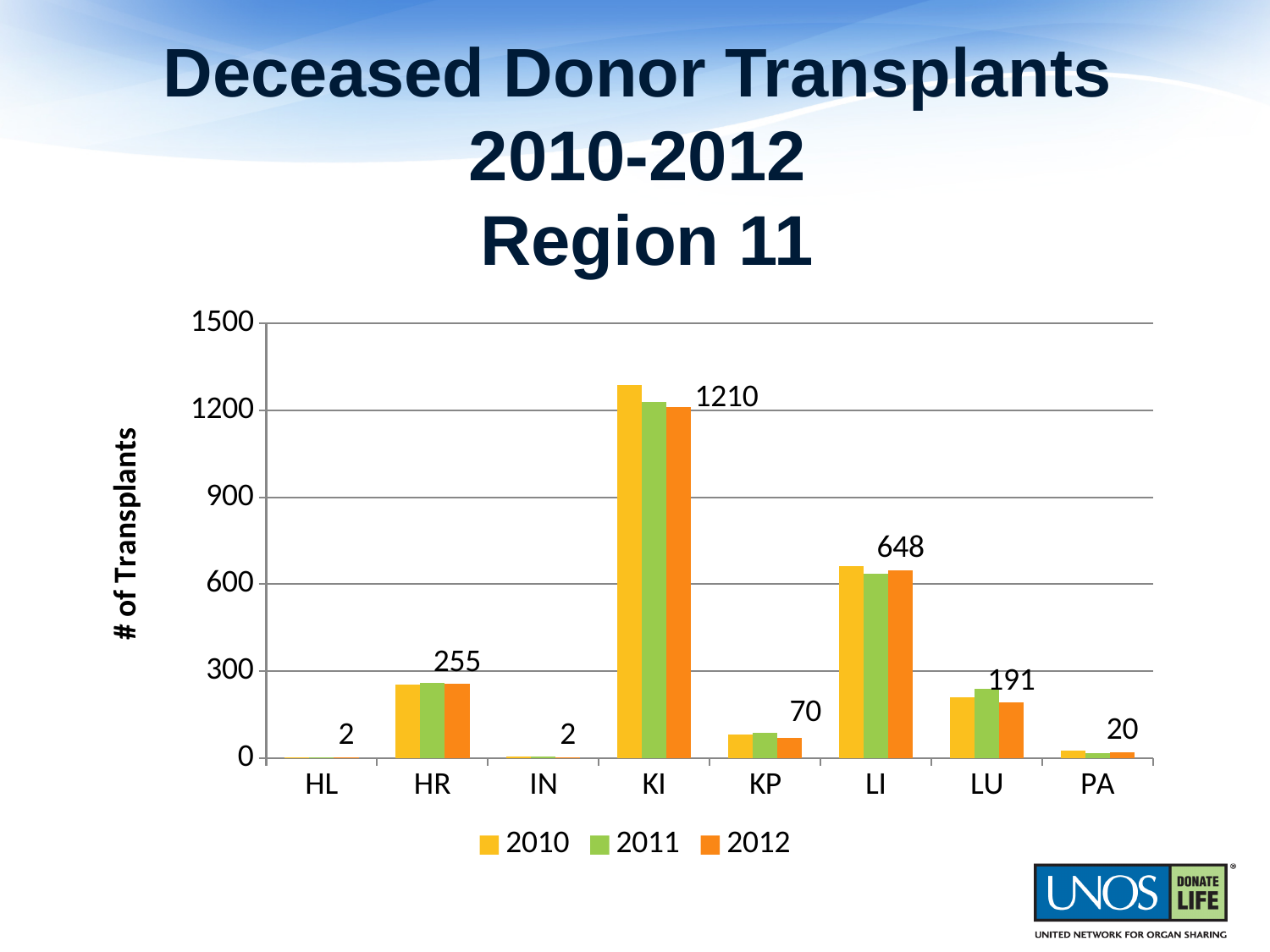
What is the 2012 value for HR? 255 What is the difference between the 2012 values for KI and LI? 562 How many series does the legend list? 3 Is the 2011 value for LU greater or less than 300? less Is the 2010 value for KI greater or less than 1200? greater What is the 2012 value for LI? 648 What is the 2012 value for KI? 1210 Which organ category has the highest number of transplants? KI What is the 2012 value for PA? 20 Which is larger in 2012, the value for LU or the value for KP? LU What kind of chart is shown on the slide? Bar chart How many organ categories are shown on the x axis? 8